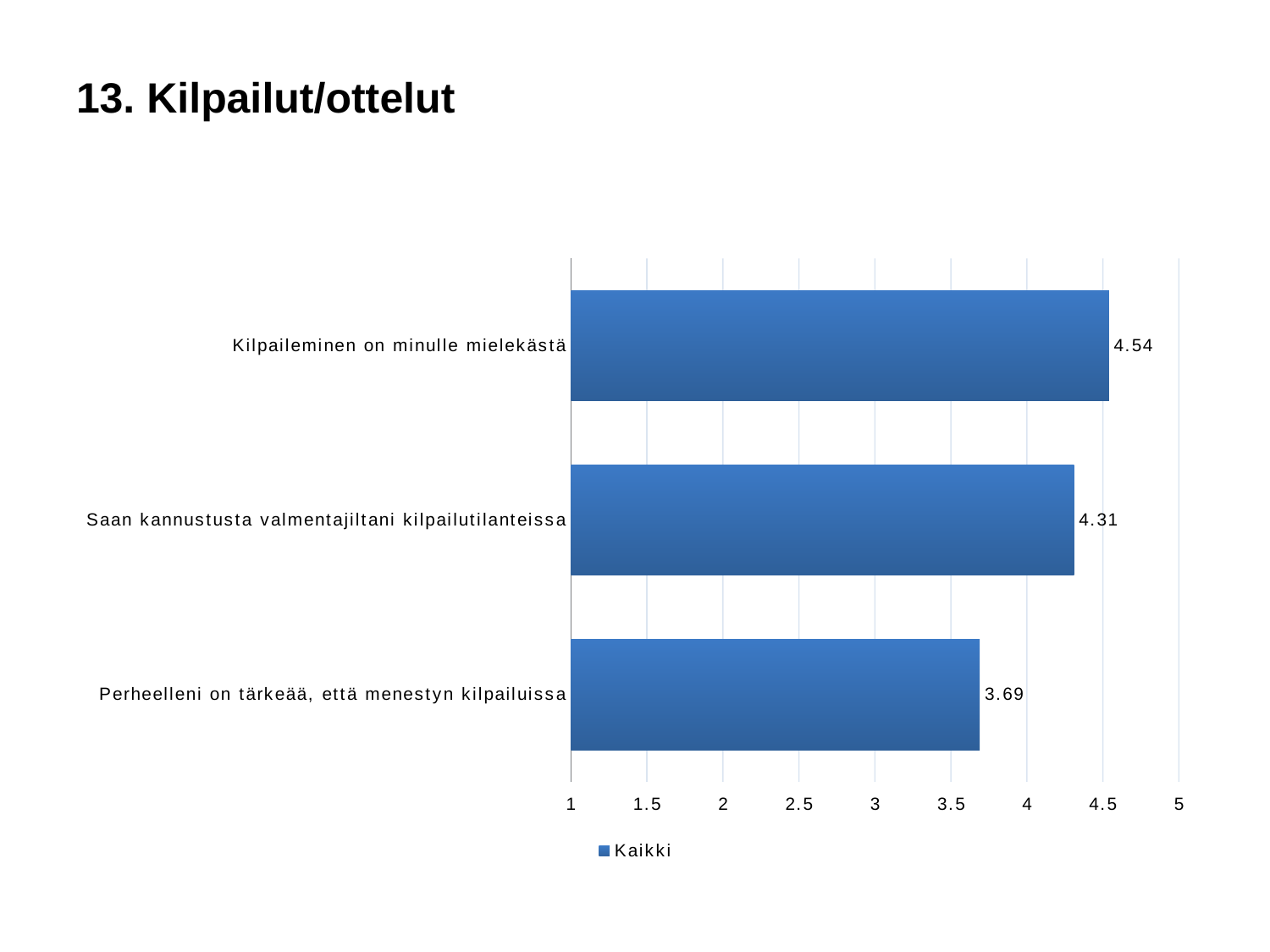
How many categories are shown in the chart? 3 What is the value for "Kilpaileminen on minulle mielekästä"? 4.54 Which category has the lowest value? Perheelleni on tärkeää, että menestyn kilpailuissa Which is larger: the value for "Saan kannustusta valmentajiltani kilpailutilanteissa" or for "Perheelleni on tärkeää, että menestyn kilpailuissa"? Saan kannustusta valmentajiltani kilpailutilanteissa What kind of chart is shown on the slide? bar chart What is the value for "Saan kannustusta valmentajiltani kilpailutilanteissa"? 4.31 What is the difference between the values for "Kilpaileminen on minulle mielekästä" and "Perheelleni on tärkeää, että menestyn kilpailuissa"? 0.85 What is the value for "Perheelleni on tärkeää, että menestyn kilpailuissa"? 3.69 Which category has the highest value? Kilpaileminen on minulle mielekästä What is the difference between the values for "Kilpaileminen on minulle mielekästä" and "Saan kannustusta valmentajiltani kilpailutilanteissa"? 0.23 How many series does the legend list? 1 Is the value for "Perheelleni on tärkeää, että menestyn kilpailuissa" greater or less than 4? less